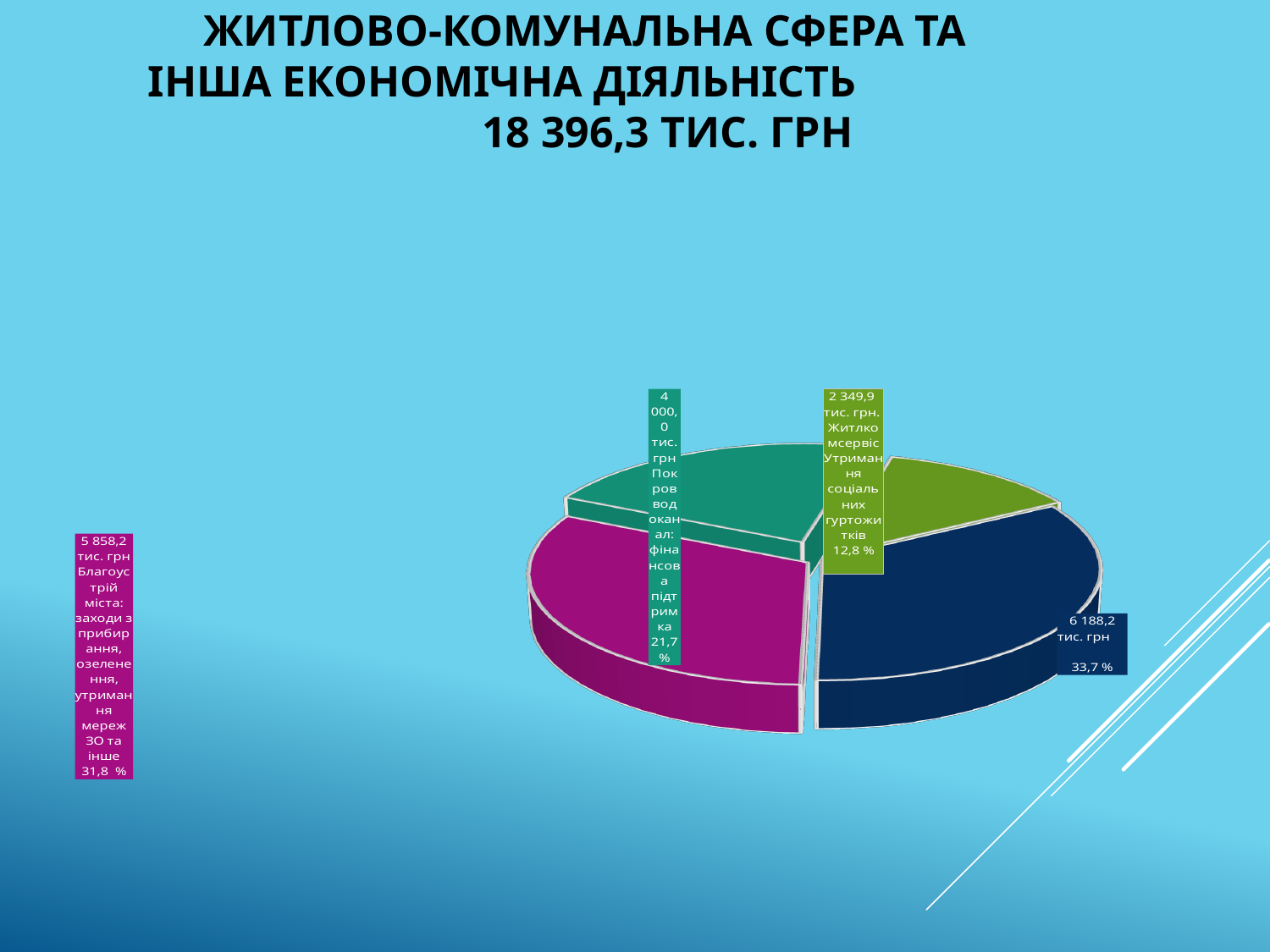
What is the value for Житлкомсервіс Утримання соціальних гуртожитків? 2 349,9 тис. грн. What total amount is stated in the slide title? 18 396,3 тис. грн What is the value for Благоустрій міста? 5 858,2 тис. грн Which labelled category has the smallest value? Житлкомсервіс Утримання соціальних гуртожитків What kind of chart is shown on the slide? Pie chart What share of the pie does Благоустрій міста represent? 31,8 % What is the value shown for the dark blue slice? 6 188,2 тис. грн Which is larger: Благоустрій міста or Покровводоканал: фінансова підтримка? Благоустрій міста How many slices does the pie chart have? 4 What is the value for Покровводоканал: фінансова підтримка? 4 000,0 тис. грн What is the difference between the value for Благоустрій міста and the value for Покровводоканал: фінансова підтримка? 1 858,2 тис. грн What share of the pie does Житлкомсервіс Утримання соціальних гуртожитків represent? 12,8 %